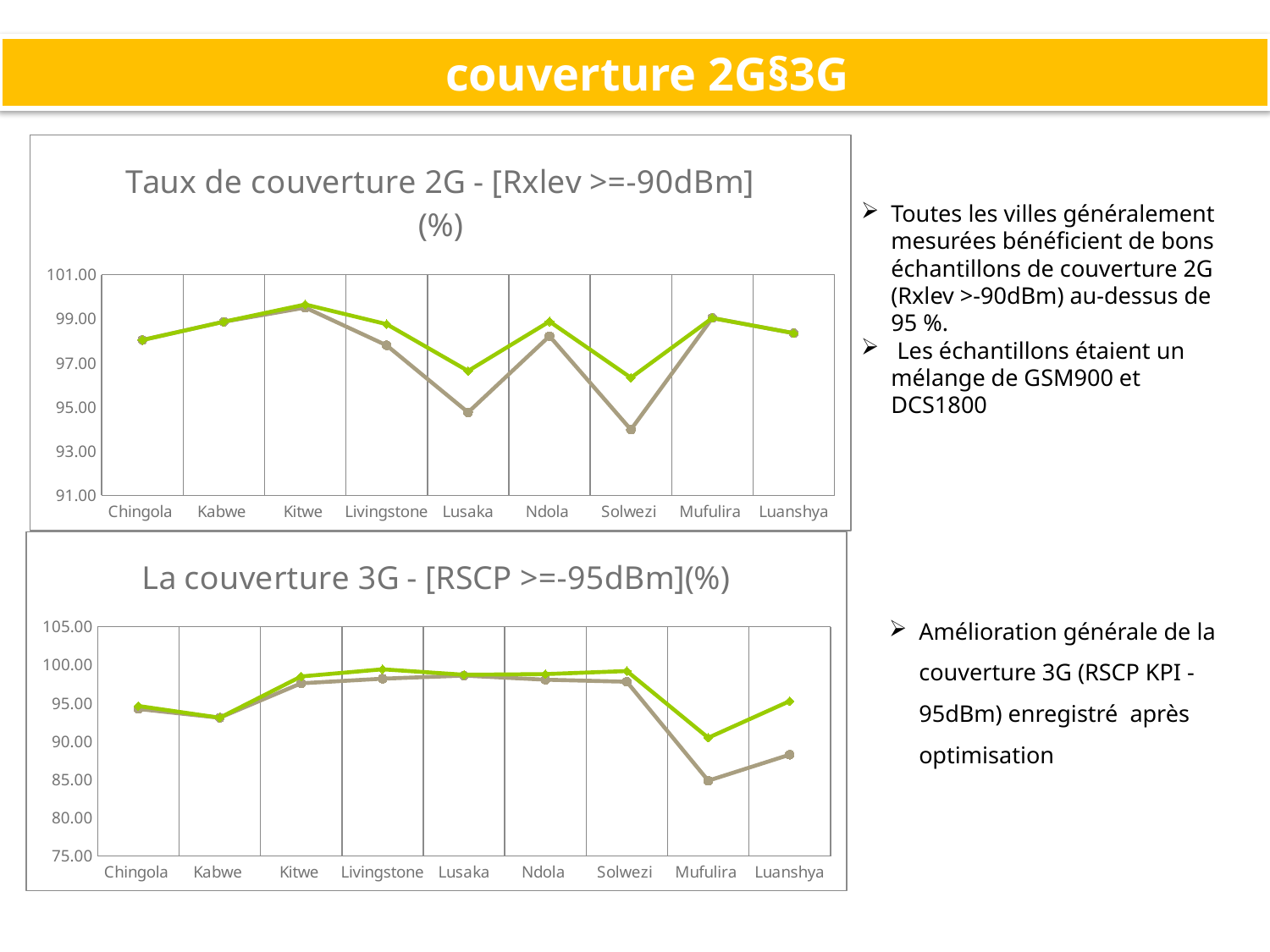
How many cities are shown on the x axis of the 'La couverture 3G - [RSCP >=-95dBm](%)' chart? 9 In the 'Taux de couverture 2G - [Rxlev >=-90dBm] (%)' chart, which city has the lowest value on the grey line? Solwezi In the 'La couverture 3G - [RSCP >=-95dBm](%)' chart, which city has the lowest value on the grey line? Mufulira In the 'La couverture 3G - [RSCP >=-95dBm](%)' chart, is the grey line value for Mufulira greater or less than 90.00? less What is the title of the lower chart on the slide? La couverture 3G - [RSCP >=-95dBm](%) In the 'Taux de couverture 2G - [Rxlev >=-90dBm] (%)' chart, is the grey line value for Solwezi greater or less than 95.00? less In the 'La couverture 3G - [RSCP >=-95dBm](%)' chart, is the green line value for Livingstone greater or less than 95.00? greater In the 'La couverture 3G - [RSCP >=-95dBm](%)' chart, which line is higher at Luanshya, the green line or the grey line? Green line How many lines are plotted in the 'Taux de couverture 2G - [Rxlev >=-90dBm] (%)' chart? 2 In the 'Taux de couverture 2G - [Rxlev >=-90dBm] (%)' chart, which city has the highest value on the green line? Kitwe What type of chart is the 'Taux de couverture 2G - [Rxlev >=-90dBm] (%)' chart? Line chart